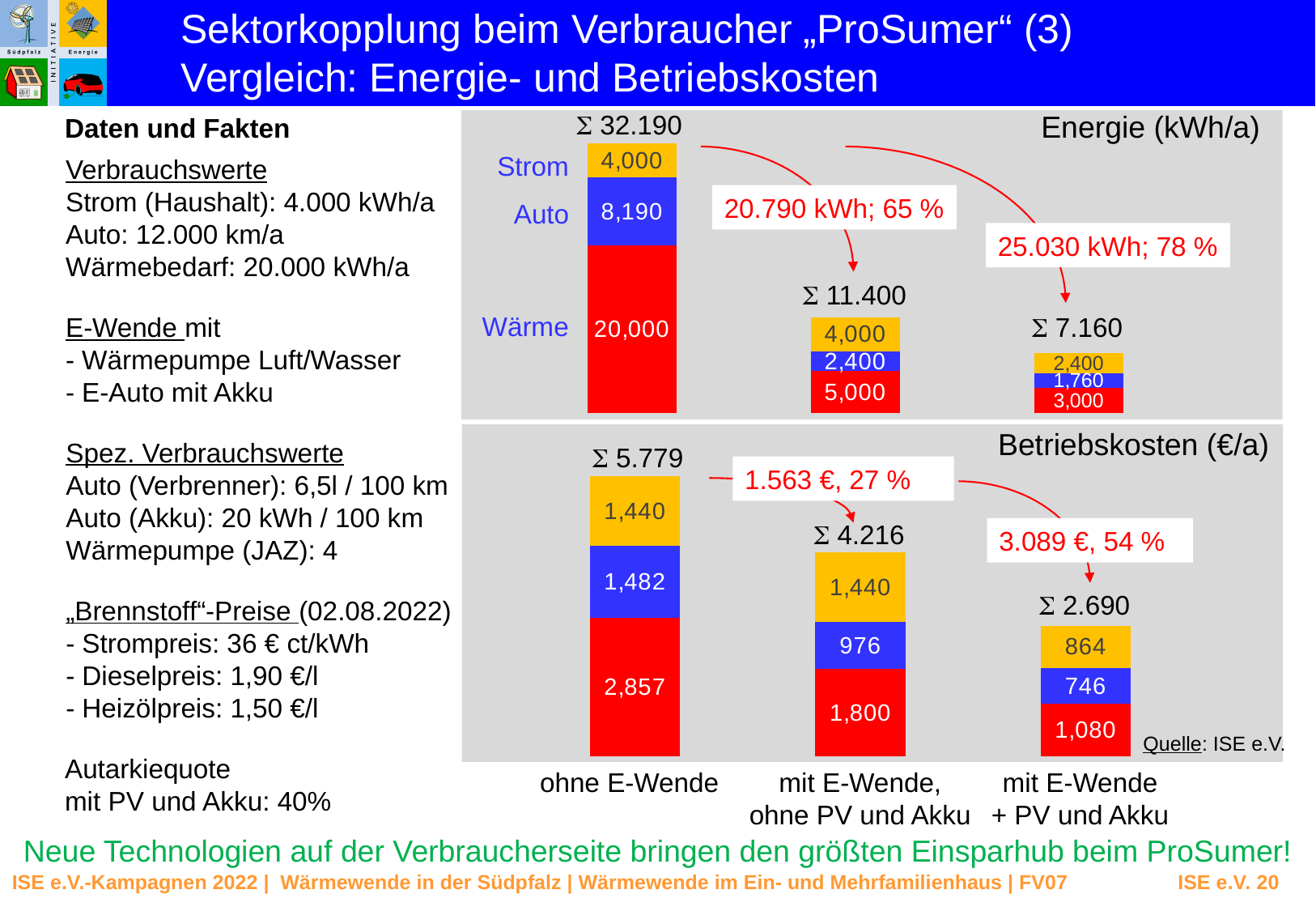
In the Betriebskosten (€/a) chart, what is the Strom value for "mit E-Wende + PV und Akku"? 864 In the Energie (kWh/a) chart, what is the Wärme value for "ohne E-Wende"? 20,000 In the Betriebskosten (€/a) chart, is the Auto value for "ohne E-Wende" larger or smaller than the Strom value for the same scenario? larger In the Betriebskosten (€/a) chart, what is the total shown for the "ohne E-Wende" bar? Σ 5.779 In the Energie (kWh/a) chart, what is the difference between the Auto value for "ohne E-Wende" and the Auto value for "mit E-Wende, ohne PV und Akku"? 5,790 In the Betriebskosten (€/a) chart, what is the Wärme value for "mit E-Wende, ohne PV und Akku"? 1,800 In the Betriebskosten (€/a) chart, which scenario has the lowest total operating cost? mit E-Wende + PV und Akku What type of chart is the Energie (kWh/a) chart? stacked bar chart How many scenarios (bars) are shown in the Betriebskosten (€/a) chart? 3 In the Energie (kWh/a) chart, which scenario has the highest total energy? ohne E-Wende In the Energie (kWh/a) chart, what is the total shown for the "mit E-Wende + PV und Akku" bar? Σ 7.160 In the Energie (kWh/a) chart, what is the Auto value for "mit E-Wende, ohne PV und Akku"? 2,400